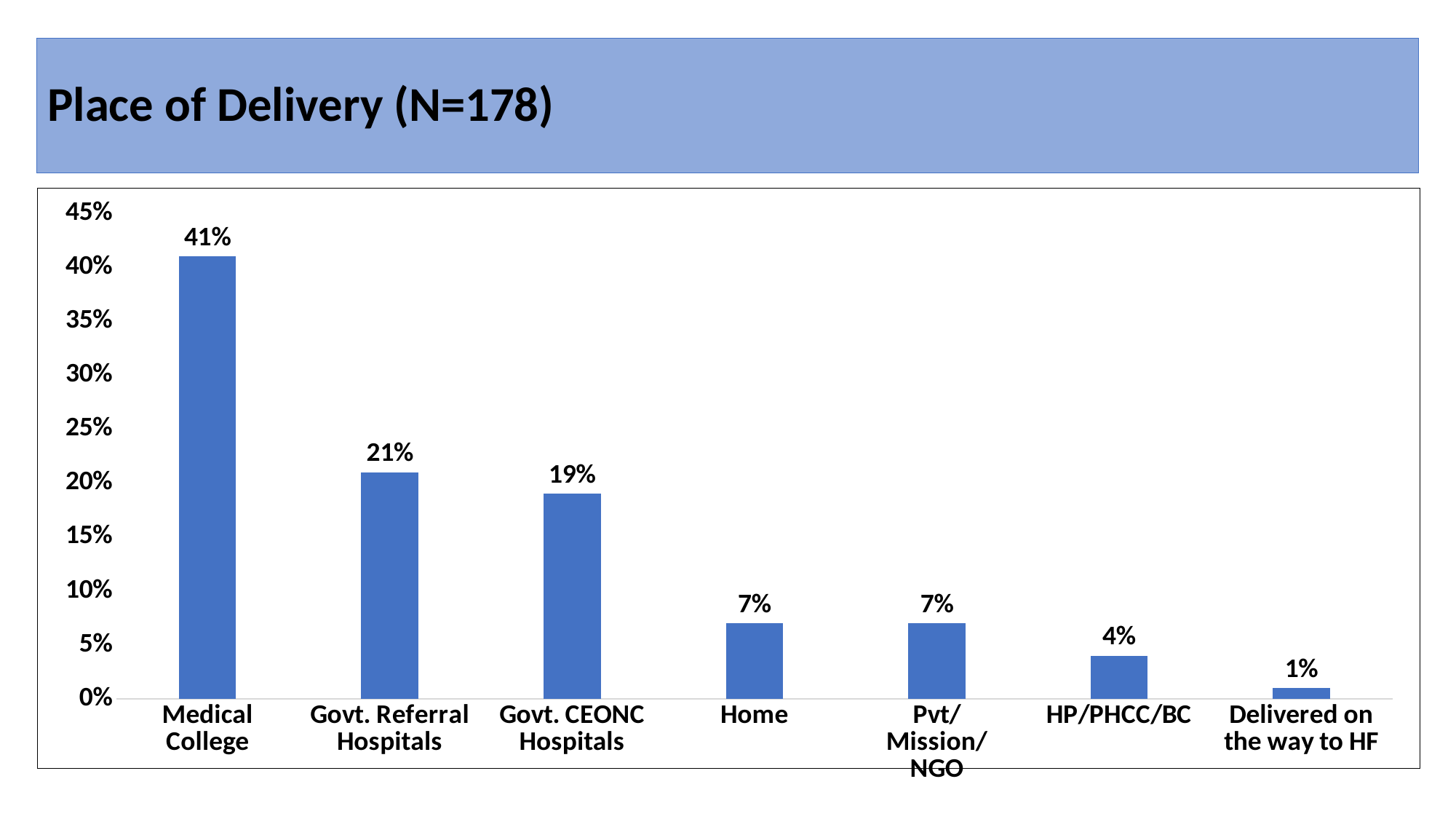
What is the value for HP/PHCC/BC? 4% How many places of delivery are shown on the chart? 7 What is the value for Govt. CEONC Hospitals? 19% What is the title of the chart? Place of Delivery (N=178) What is the value for Medical College? 41% Which place of delivery has the lowest value? Delivered on the way to HF What is the difference between the values for Medical College and Govt. Referral Hospitals? 20% Which is larger, the value for Govt. Referral Hospitals or Govt. CEONC Hospitals? Govt. Referral Hospitals Is the value for Medical College greater or less than 40%? greater What kind of chart is shown on the slide? Bar chart Which place of delivery has the highest value? Medical College What is the value for Delivered on the way to HF? 1%